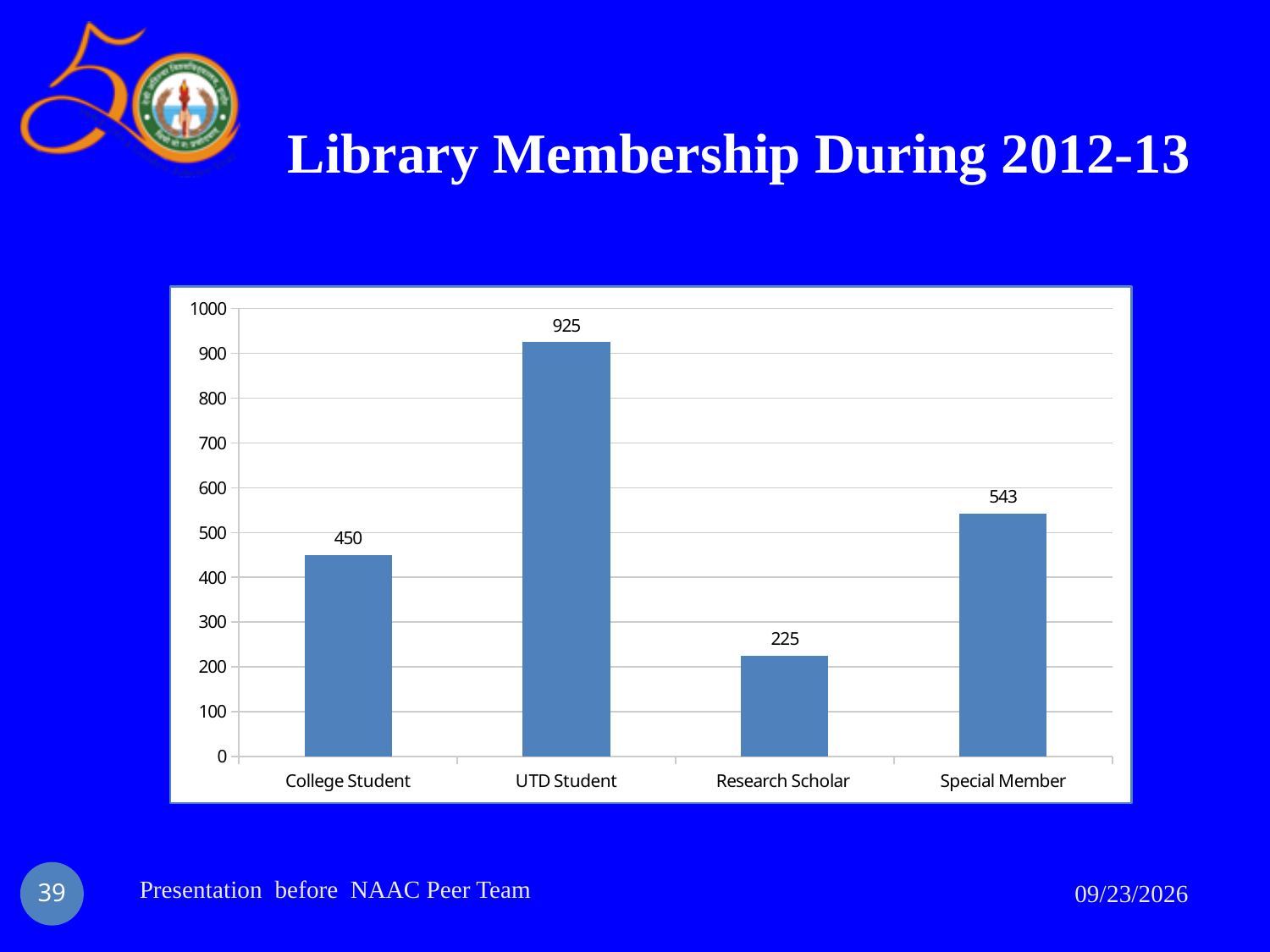
What is the library membership value for Special Member? 543 How many categories are shown on the chart? 4 Which is larger, the membership for Special Member or for College Student? Special Member Which category has the highest library membership? UTD Student Which category has the lowest library membership? Research Scholar What is the title of the slide containing the chart? Library Membership During 2012-13 What is the difference between the UTD Student and College Student membership values? 475 What is the library membership value for Research Scholar? 225 What kind of chart is shown on the slide? Bar chart What is the library membership value for College Student? 450 What is the difference between the Special Member and Research Scholar membership values? 318 What is the library membership value for UTD Student? 925